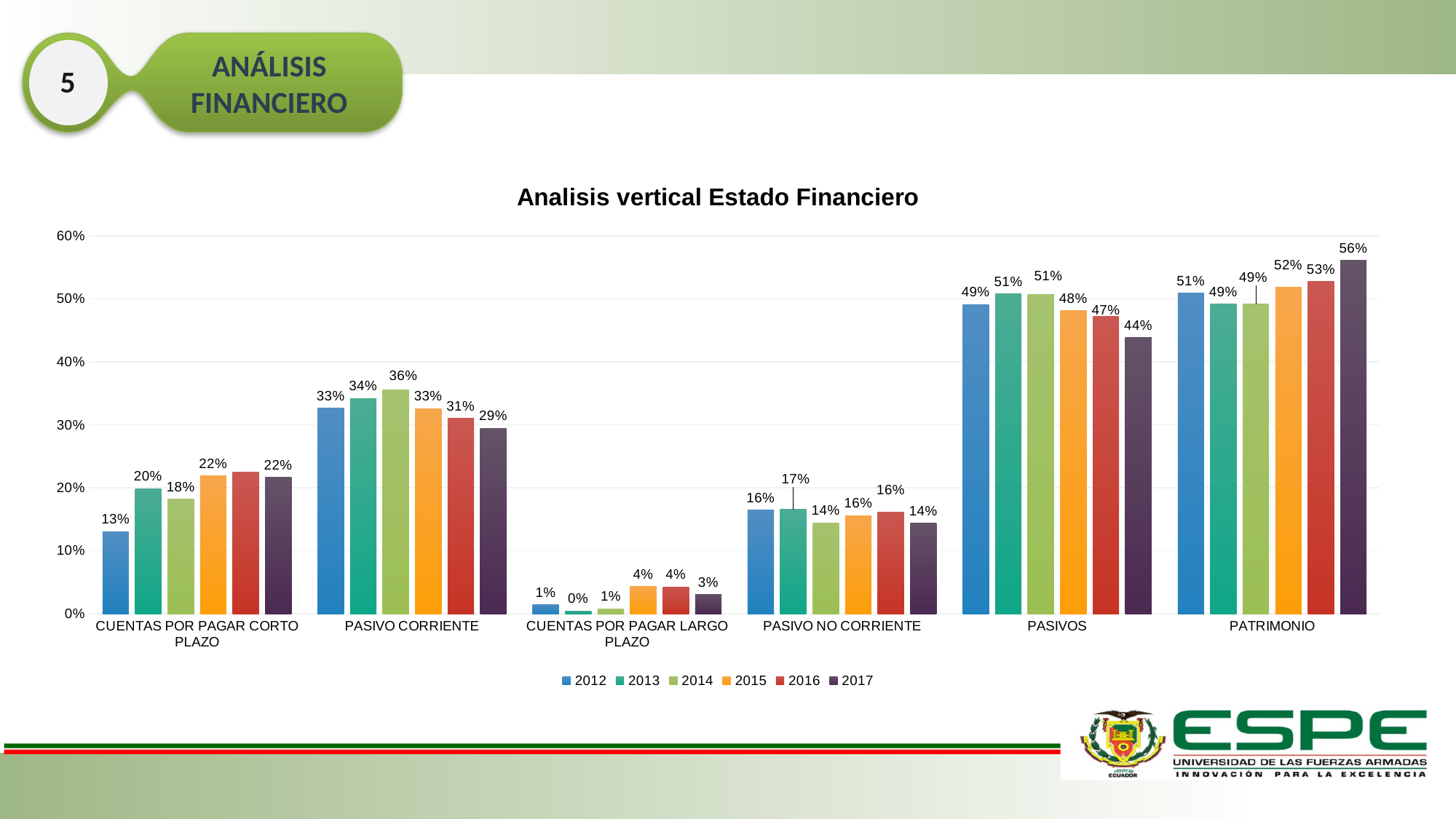
How many series does the legend list? 6 What is the value for PATRIMONIO in 2017? 56% How many categories are shown on the x axis? 6 What is the value for PASIVOS in 2017? 44% Which year has the lowest value for PASIVO CORRIENTE? 2017 Which year has the highest value for PATRIMONIO? 2017 What is the title of the chart? Analisis vertical Estado Financiero What is the value for CUENTAS POR PAGAR CORTO PLAZO in 2012? 13% Which is larger for PASIVOS: the 2013 value or the 2017 value? 2013 What kind of chart is shown on the slide? Bar chart What is the value for PASIVO CORRIENTE in 2014? 36% What is the difference between the 2017 and 2012 values for PATRIMONIO? 5%